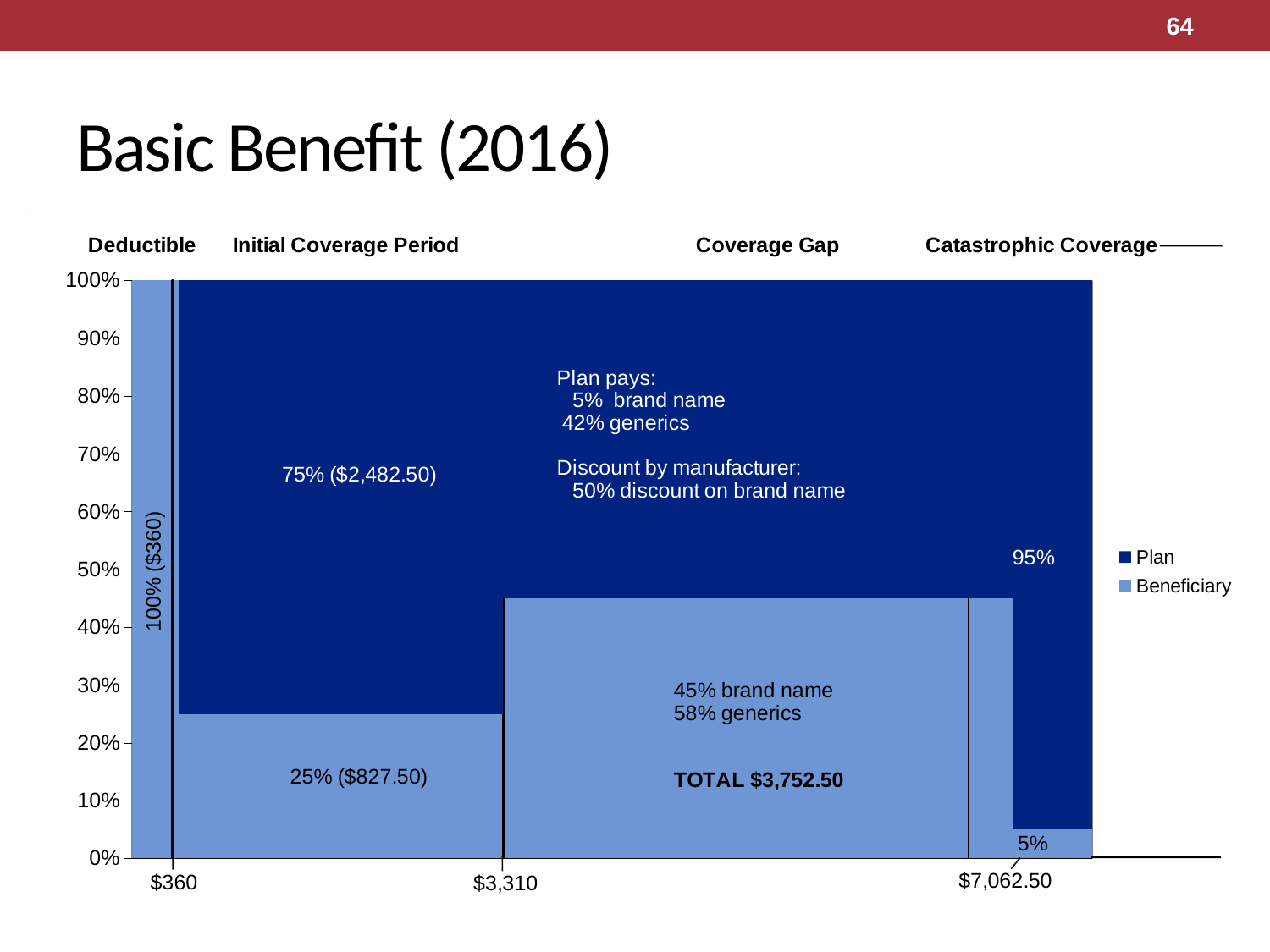
In Catastrophic Coverage, what is the difference in percentage points between the Plan share and the Beneficiary share? 90 percentage points What TOTAL dollar amount is printed in the Coverage Gap section? $3,752.50 What are the two series named in the legend? Plan and Beneficiary What is the Beneficiary share shown for Catastrophic Coverage? 5% How many series does the legend list? 2 How many benefit phases are labelled across the top of the chart? 4 What is the Plan share shown for Catastrophic Coverage? 95% What is the Beneficiary share shown for the Initial Coverage Period? 25% ($827.50) What is the Beneficiary share shown for the Deductible phase? 100% ($360) What kind of chart is shown on the slide? Stacked bar chart In the Initial Coverage Period, which is larger, the Plan share or the Beneficiary share? Plan What is the Plan share shown for the Initial Coverage Period? 75% ($2,482.50)